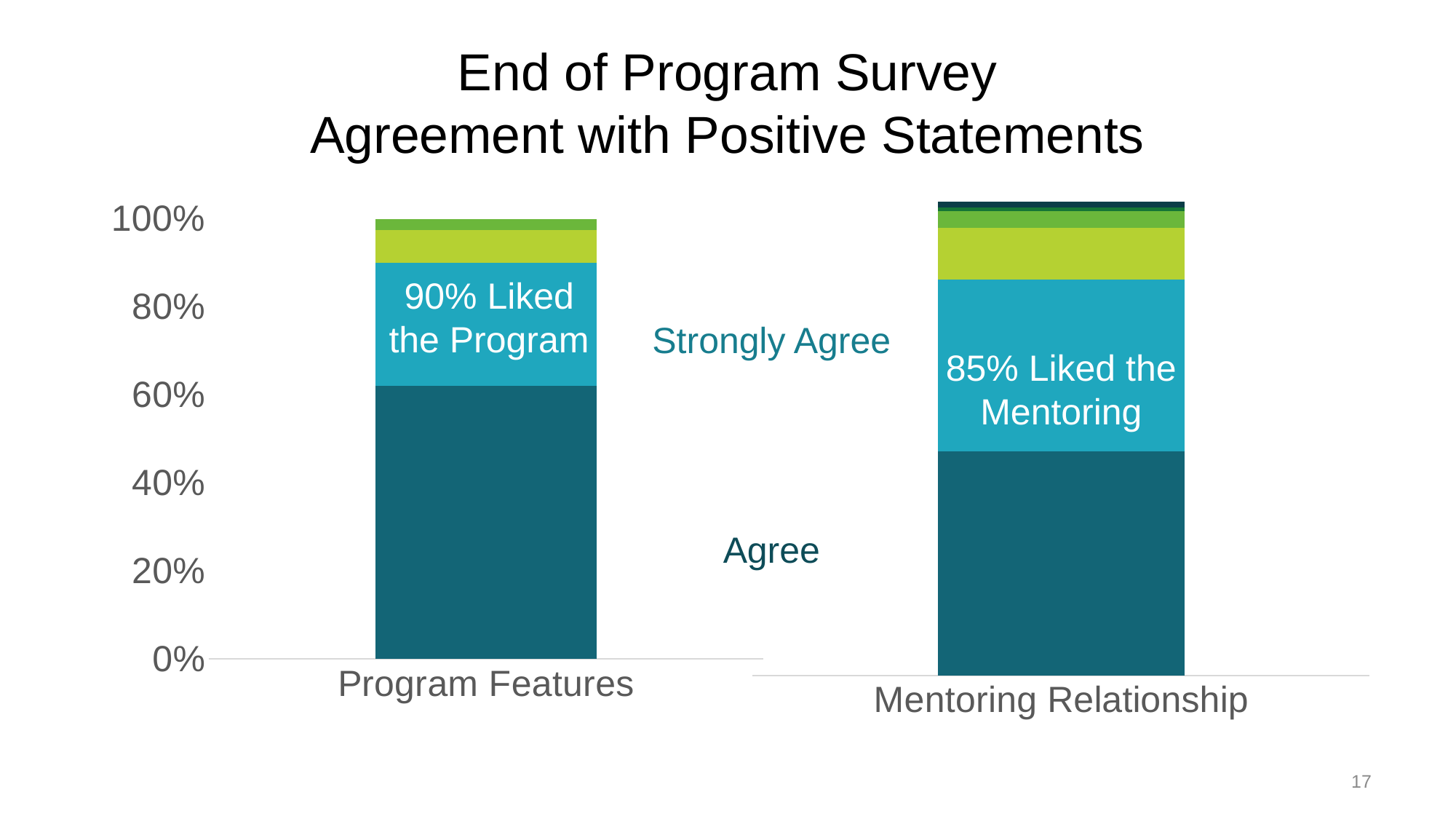
How many categories are plotted on the x axis of the chart? 2 What percentage of respondents liked the mentoring, according to the label on the Mentoring Relationship bar? 85% What is the title of the chart? End of Program Survey Agreement with Positive Statements What kind of chart is shown on the slide? bar chart Which category has the higher labelled percentage of positive agreement, Program Features or Mentoring Relationship? Program Features Which category has the lower labelled percentage of positive agreement? Mentoring Relationship What are the two response categories labelled in the middle of the chart? Strongly Agree and Agree Is the Agree segment of the Mentoring Relationship bar greater or less than 60%? less What percentage of respondents liked the program, according to the label on the Program Features bar? 90% What is the difference between the percentage who liked the program and the percentage who liked the mentoring? 5%